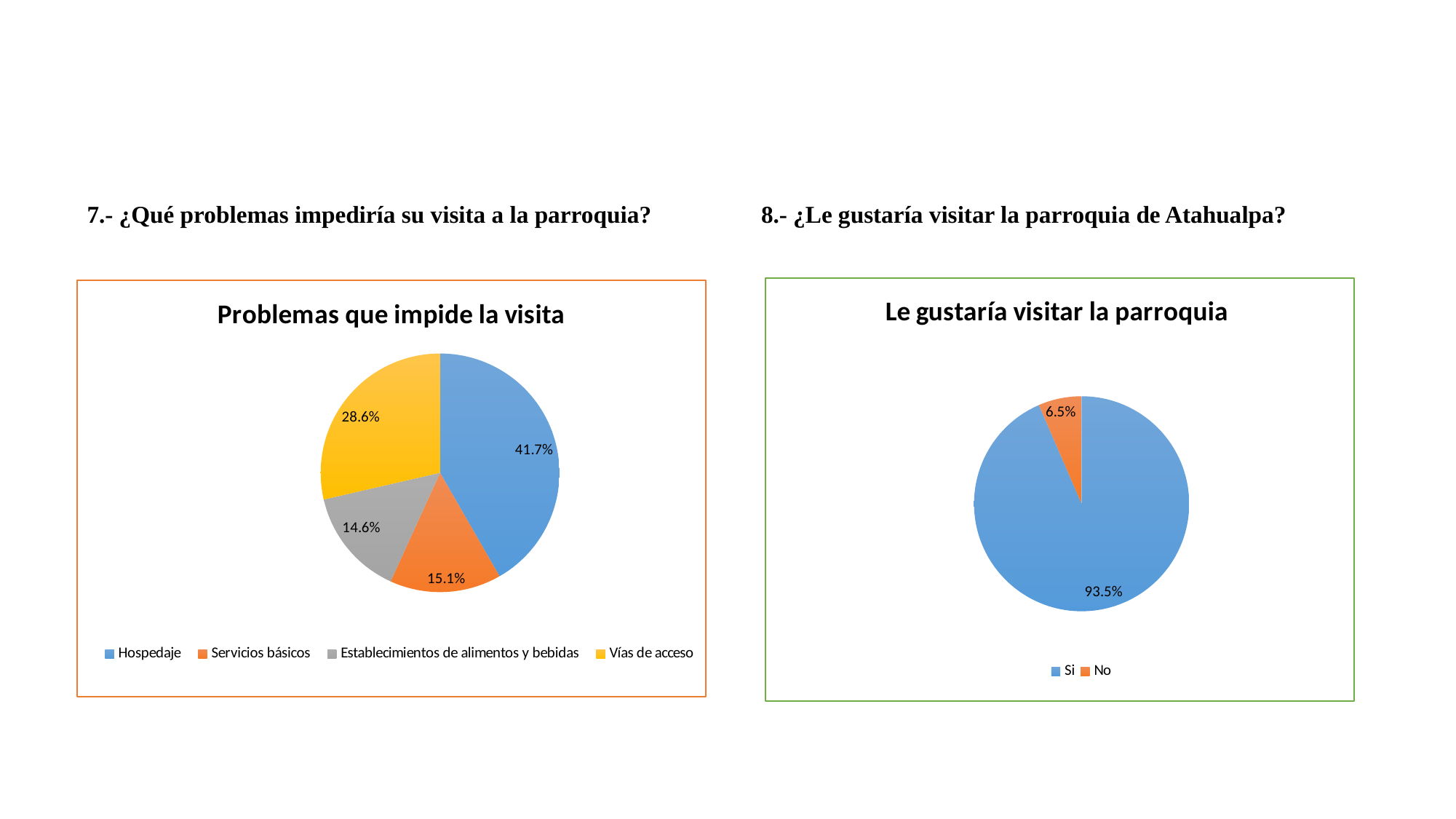
In the chart titled "Le gustaría visitar la parroquia", how many entries does the legend list? 2 In the chart titled "Le gustaría visitar la parroquia", what share does Si have? 93.5% In the chart titled "Problemas que impide la visita", which is larger, Servicios básicos or Vías de acceso? Vías de acceso In the chart titled "Problemas que impide la visita", what share does Establecimientos de alimentos y bebidas have? 14.6% In the chart titled "Problemas que impide la visita", what share does Hospedaje have? 41.7% In the chart titled "Problemas que impide la visita", which category has the largest slice? Hospedaje In the chart titled "Problemas que impide la visita", what is the difference between the Hospedaje and Vías de acceso shares? 13.1% In the chart titled "Problemas que impide la visita", how many categories are shown? 4 What kind of chart is the chart titled "Le gustaría visitar la parroquia"? Pie chart In the chart titled "Le gustaría visitar la parroquia", what share does No have? 6.5% In the chart titled "Problemas que impide la visita", which category has the smallest slice? Establecimientos de alimentos y bebidas In the chart titled "Problemas que impide la visita", what share does Vías de acceso have? 28.6%